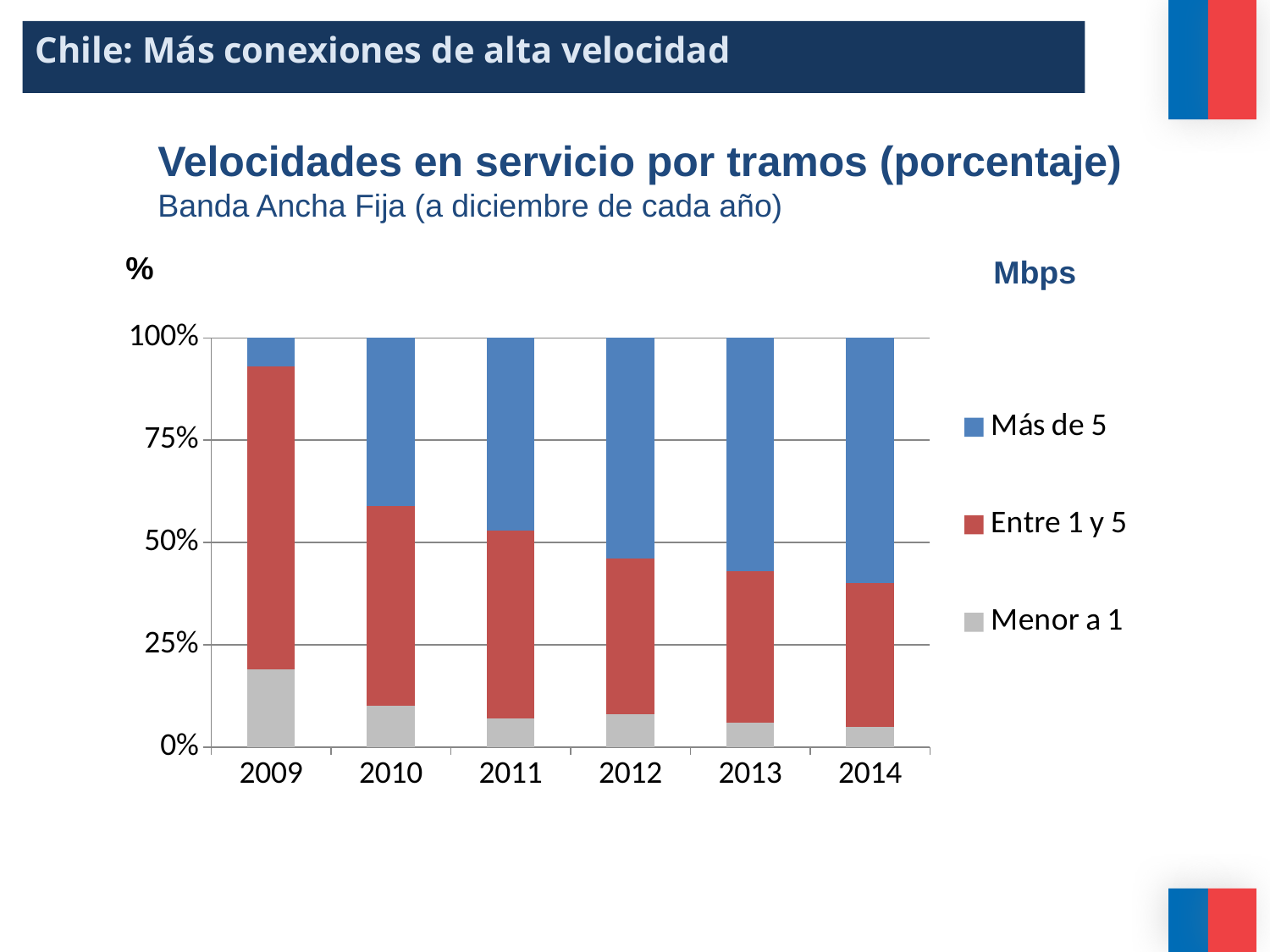
How many series does the chart legend list? 3 In which year is the 'Entre 1 y 5' segment the smallest? 2014 What unit do the legend categories refer to, as labelled above the legend? Mbps In which year is the 'Más de 5' segment the largest? 2014 How many years are shown on the x axis of the chart? 6 What kind of chart is shown on the slide? Stacked bar chart Which is larger in 2010: the 'Entre 1 y 5' segment or the 'Más de 5' segment? Entre 1 y 5 Does the share of 'Menor a 1' Mbps rise or fall from 2009 to 2014? Fall Does the share of 'Más de 5' Mbps rise or fall from 2009 to 2014? Rise Is the share of 'Más de 5' in 2009 greater or less than 25%? less Is the share of 'Más de 5' in 2014 greater or less than 50%? greater In which year is the 'Menor a 1' segment the largest? 2009